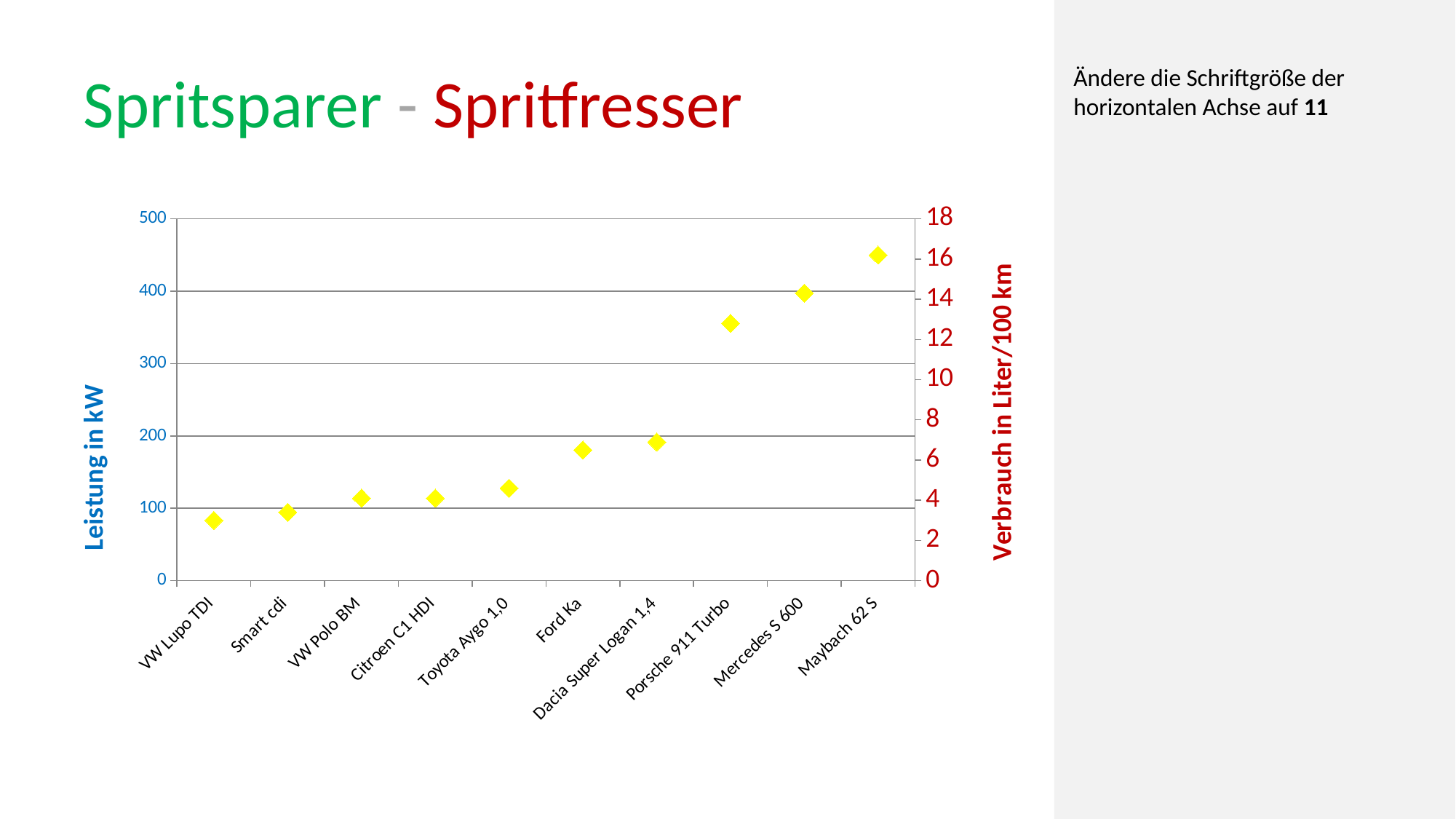
Which has the higher plotted value, Porsche 911 Turbo or Ford Ka? Porsche 911 Turbo What kind of chart is shown on the slide? scatter chart Do the plotted values rise or fall from left to right along the x axis? rise Reading against the left-hand axis, is the point for Smart cdi greater or less than 200? less What is the title of the left-hand vertical axis? Leistung in kW Which car model has the highest plotted point in the chart? Maybach 62 S Reading against the left-hand axis, is the point for Porsche 911 Turbo greater or less than 300? greater Which has the higher plotted value, Dacia Super Logan 1,4 or Mercedes S 600? Mercedes S 600 Which car model has the lowest plotted point in the chart? VW Lupo TDI What is the title of the right-hand vertical axis? Verbrauch in Liter/100 km Which has the higher plotted value, Toyota Aygo 1,0 or Ford Ka? Ford Ka How many car models are plotted on the x axis of the chart? 10